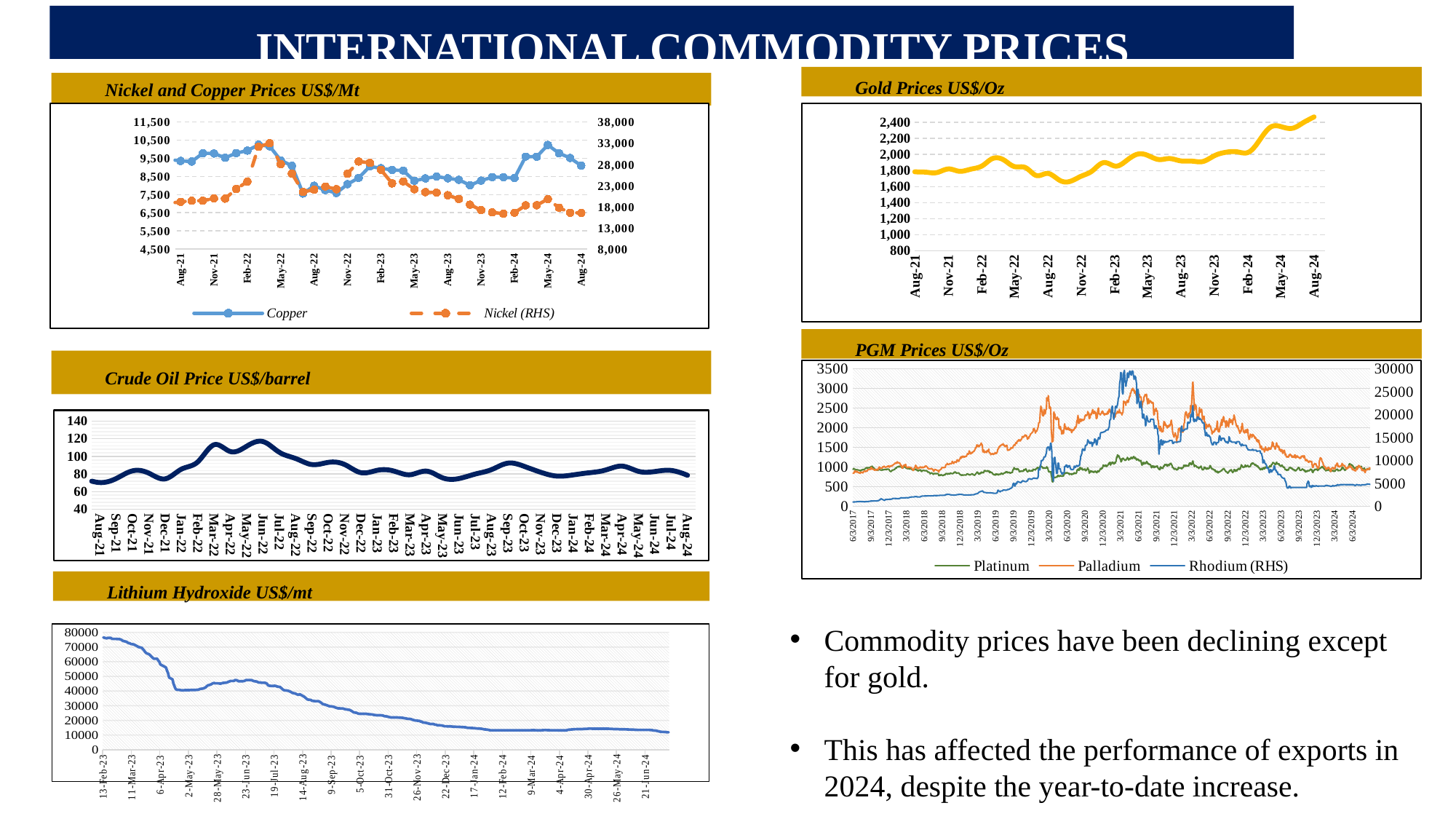
On the Gold Prices chart, do values overall rise or fall from Aug-21 to Aug-24? rise On the Gold Prices chart, is the value for Aug-21 greater or less than 2,000? less On the Crude Oil Price chart, is the value for Jun-22 greater or less than 100? greater On the Lithium Hydroxide chart, do values overall rise or fall from 13-Feb-23 to 21-Jun-24? fall On the Nickel and Copper Prices chart, which series is plotted on the right-hand axis according to the legend? Nickel (RHS) On the PGM Prices chart, how many series does the legend list? 3 On the Nickel and Copper Prices chart, how many series does the legend list? 2 On the Gold Prices chart, is the value for Aug-24 greater or less than 2,400? greater On the PGM Prices chart, which series is plotted on the right-hand axis according to the legend? Rhodium (RHS) What kind of chart is the Gold Prices chart? line chart